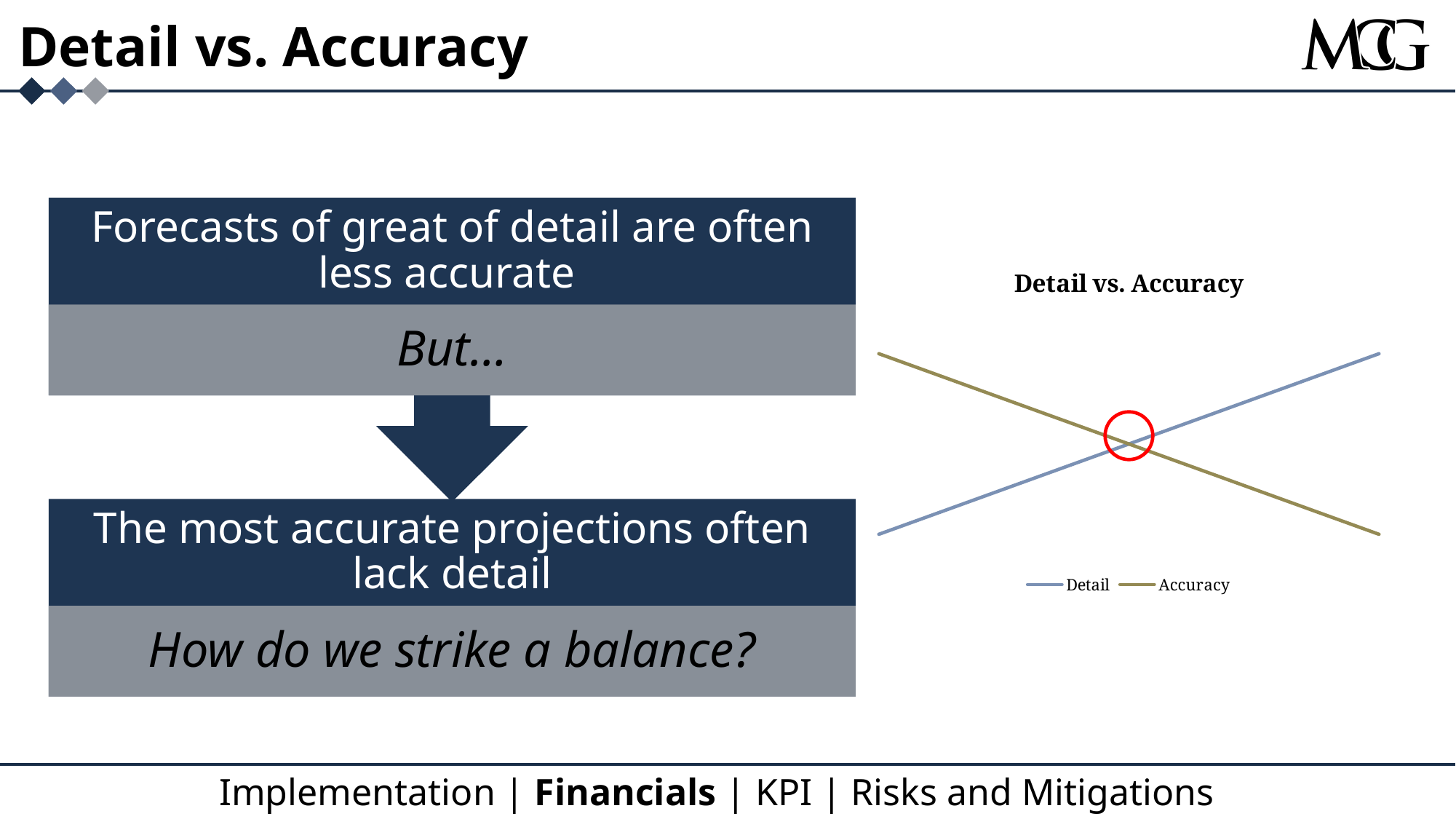
Does the Accuracy line rise or fall from left to right? falls What is the title of the chart? Detail vs. Accuracy Which series is drawn in the olive/gold colour? Accuracy Does the Detail line rise or fall from left to right? rises How many series does the chart's legend list? 2 What kind of chart is shown on the slide? line chart